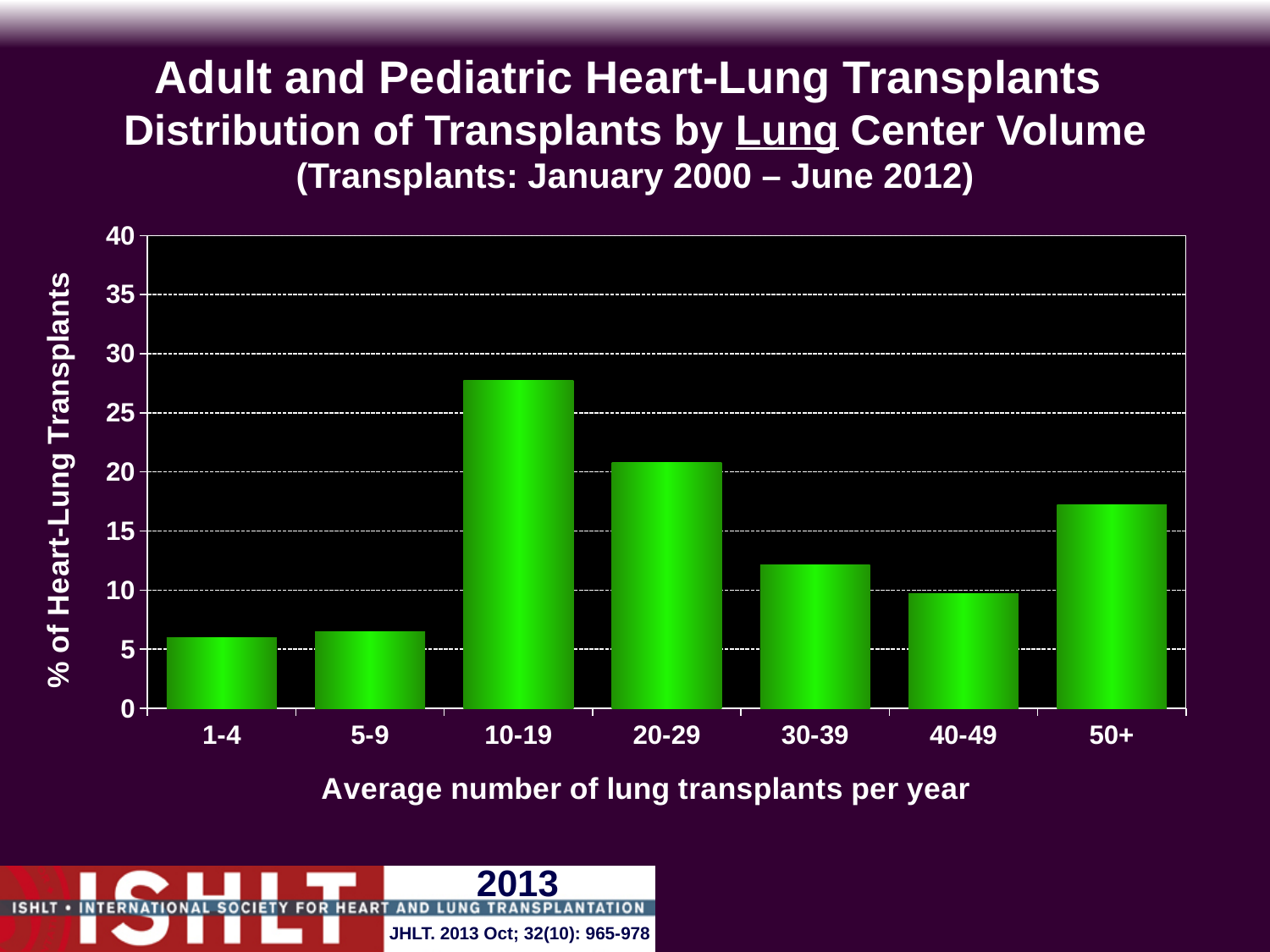
Is the value for the 10-19 category greater or less than 25? greater Which has a larger percentage of heart-lung transplants, the 50+ category or the 30-39 category? 50+ What is the label of the y axis? % of Heart-Lung Transplants Is the value for the 5-9 category greater or less than 10? less Is the value for the 30-39 category greater or less than 10? greater Which has a larger percentage of heart-lung transplants, the 10-19 category or the 20-29 category? 10-19 What is the label of the x axis? Average number of lung transplants per year What kind of chart is shown on the slide? bar chart How many center volume categories are shown on the x axis? 7 Which center volume category has the highest percentage of heart-lung transplants? 10-19